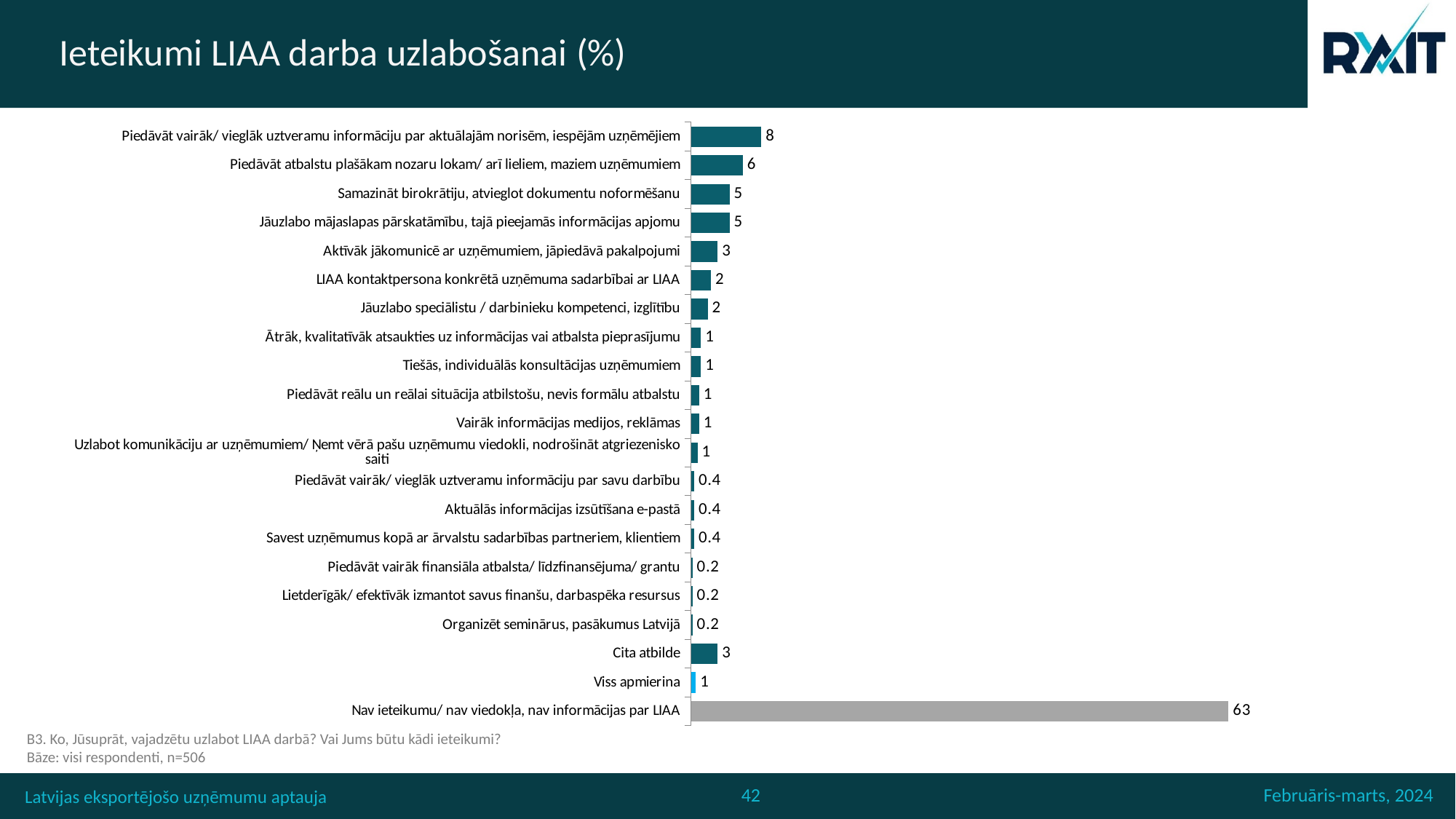
What is the value for "Aktuālās informācijas izsūtīšana e-pastā"? 0.4 What is the value for "Nav ieteikumu/ nav viedokļa, nav informācijas par LIAA"? 63 What is the difference between the values for "Piedāvāt vairāk/ vieglāk uztveramu informāciju par aktuālajām norisēm, iespējām uzņēmējiem" and "Piedāvāt atbalstu plašākam nozaru lokam/ arī lieliem, maziem uzņēmumiem"? 2 Which category has the highest value among the suggestions (excluding "Nav ieteikumu/ nav viedokļa, nav informācijas par LIAA")? Piedāvāt vairāk/ vieglāk uztveramu informāciju par aktuālajām norisēm, iespējām uzņēmējiem Which is larger: the value for "Aktīvāk jākomunicē ar uzņēmumiem, jāpiedāvā pakalpojumi" or the value for "LIAA kontaktpersona konkrētā uzņēmuma sadarbībai ar LIAA"? Aktīvāk jākomunicē ar uzņēmumiem, jāpiedāvā pakalpojumi Which category has the highest value? Nav ieteikumu/ nav viedokļa, nav informācijas par LIAA How many categories are shown in the chart? 21 What kind of chart is shown on the slide? Bar chart What is the title of the slide? Ieteikumi LIAA darba uzlabošanai (%) What is the value for "Cita atbilde"? 3 What is the value for "Organizēt seminārus, pasākumus Latvijā"? 0.2 What is the value for "Samazināt birokrātiju, atvieglot dokumentu noformēšanu"? 5